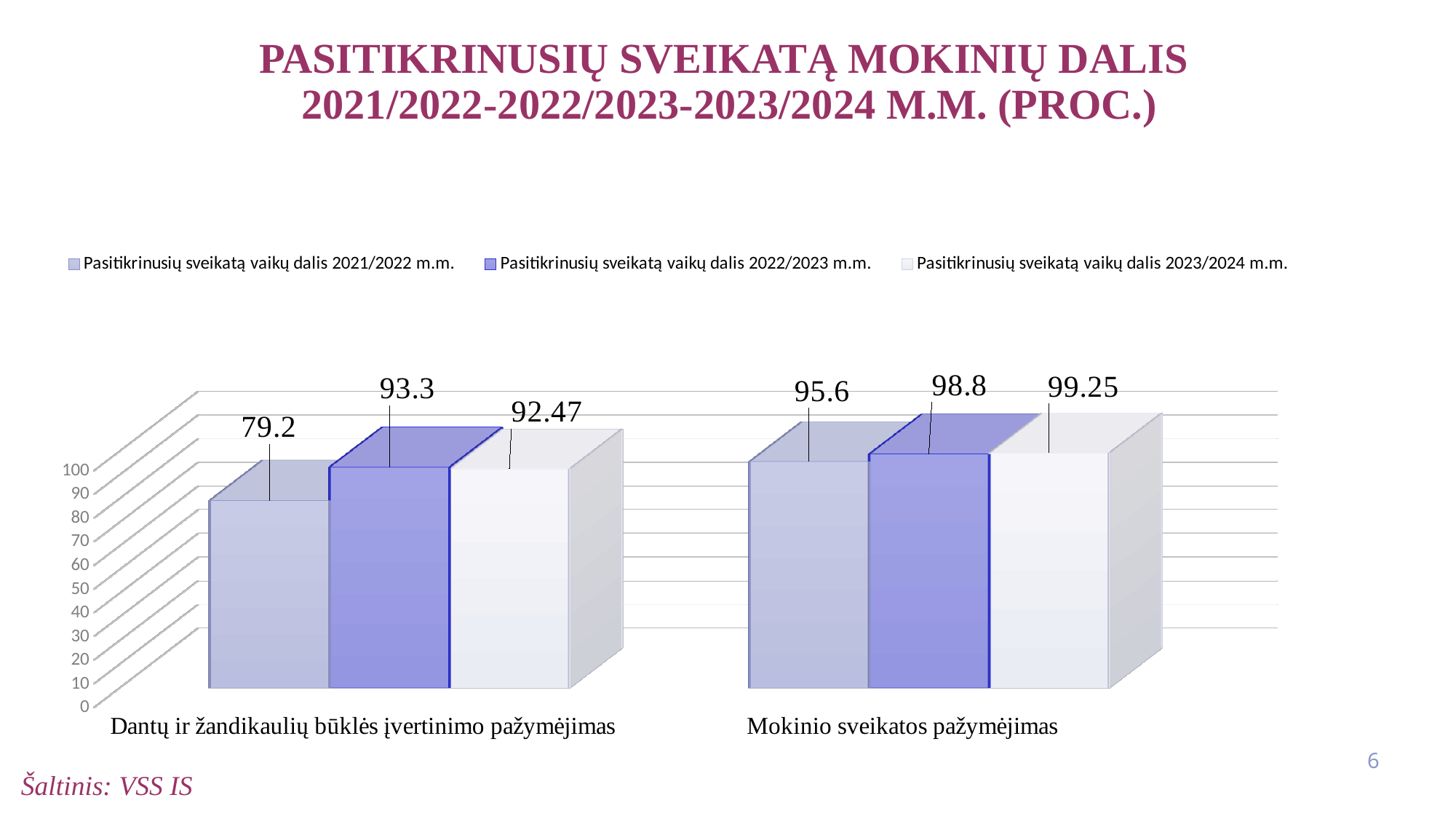
What kind of chart is shown on the slide? Bar chart What is the value for "Mokinio sveikatos pažymėjimas" in the 2023/2024 m.m. series? 99.25 What is the value for "Dantų ir žandikaulių būklės įvertinimo pažymėjimas" in the 2022/2023 m.m. series? 93.3 What is the value for "Dantų ir žandikaulių būklės įvertinimo pažymėjimas" in the 2021/2022 m.m. series? 79.2 Which category has the highest value in the 2023/2024 m.m. series? Mokinio sveikatos pažymėjimas What source is cited at the bottom of the slide? VSS IS What is the value for "Mokinio sveikatos pažymėjimas" in the 2021/2022 m.m. series? 95.6 Which is larger for "Mokinio sveikatos pažymėjimas": the 2021/2022 m.m. value or the 2022/2023 m.m. value? 2022/2023 m.m. How many categories are shown on the x axis? 2 How many series does the legend list? 3 What is the difference between the 2022/2023 m.m. and 2021/2022 m.m. values for "Dantų ir žandikaulių būklės įvertinimo pažymėjimas"? 14.1 Which category has the lowest value in the 2021/2022 m.m. series? Dantų ir žandikaulių būklės įvertinimo pažymėjimas